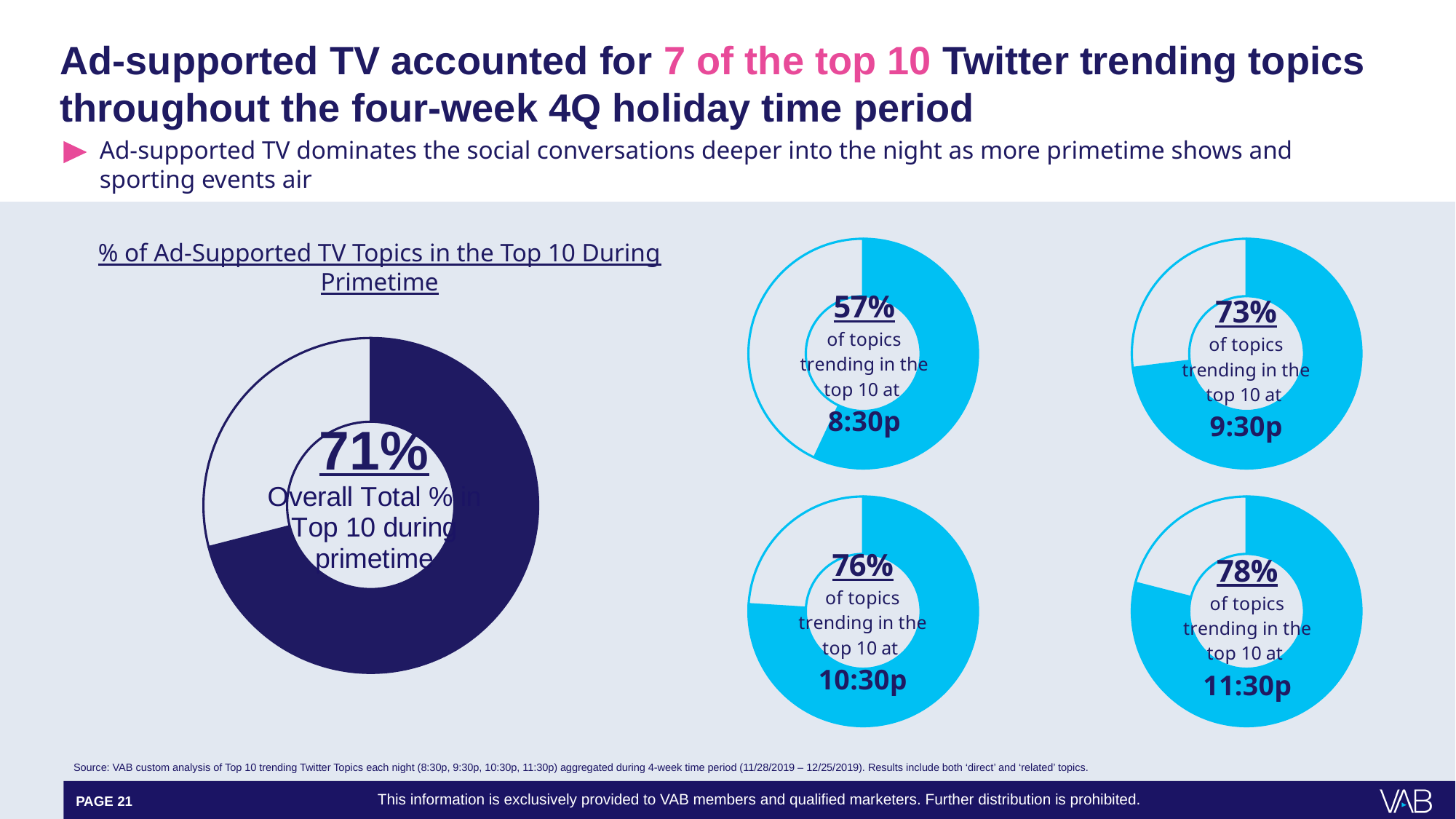
What is the difference in percentage points between the 11:30p donut chart and the 8:30p donut chart? 21 Do the percentages in the four small donut charts rise or fall as the time slots get later (8:30p to 11:30p)? rise Among the four small time-slot donut charts, which time slot has the lowest percentage? 8:30p How many small time-slot donut charts are shown on the right side of the slide? 4 In the small donut chart for 9:30p, what percentage of topics trending in the top 10 is shown? 73% In the large donut chart titled '% of Ad-Supported TV Topics in the Top 10 During Primetime', what overall percentage is shown? 71% Among the four small time-slot donut charts, which time slot has the highest percentage? 11:30p Which is larger: the percentage in the 9:30p donut chart or the percentage in the 10:30p donut chart? 10:30p In the small donut chart for 8:30p, what percentage of topics trending in the top 10 is shown? 57% In the small donut chart for 11:30p, what percentage of topics trending in the top 10 is shown? 78% In the small donut chart for 10:30p, what percentage of topics trending in the top 10 is shown? 76% What type of chart is the large chart on the left side of the slide? donut chart